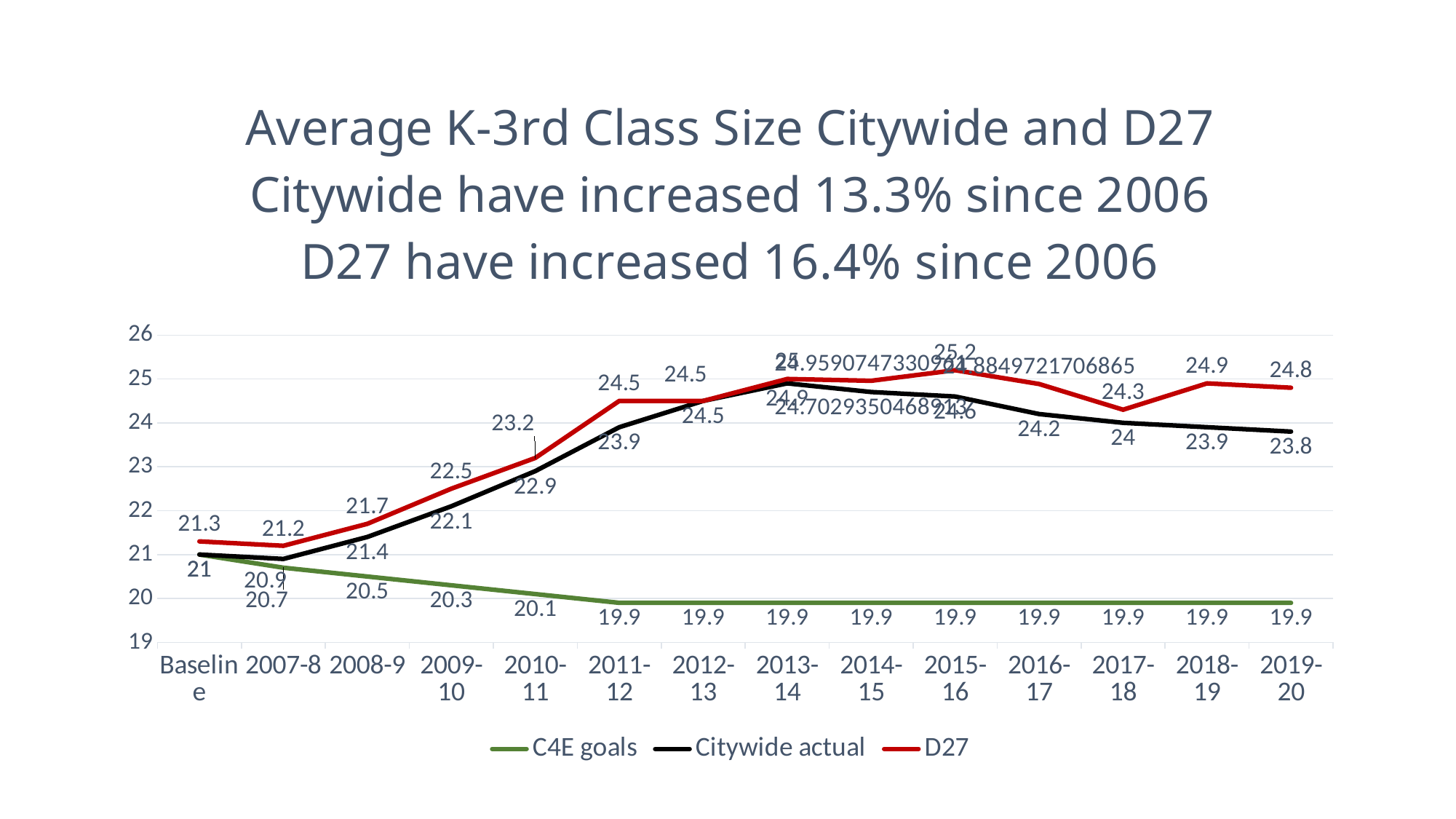
Which category has the highest C4E goals value? Baseline What colour is the D27 line? red What is the Citywide actual value for 2010-11? 22.9 What kind of chart is shown on the slide? line chart What is the C4E goals value for 2009-10? 20.3 What is the difference between the D27 value and the Citywide actual value in 2019-20? 1 How many series does the legend list? 3 Is the Citywide actual value for 2014-15 greater or less than 24? greater How many categories are shown along the x axis? 14 What is the D27 value for 2019-20? 24.8 In 2018-19, which is larger: the D27 value or the Citywide actual value? D27 Do the C4E goals values rise or fall from Baseline to 2011-12? fall